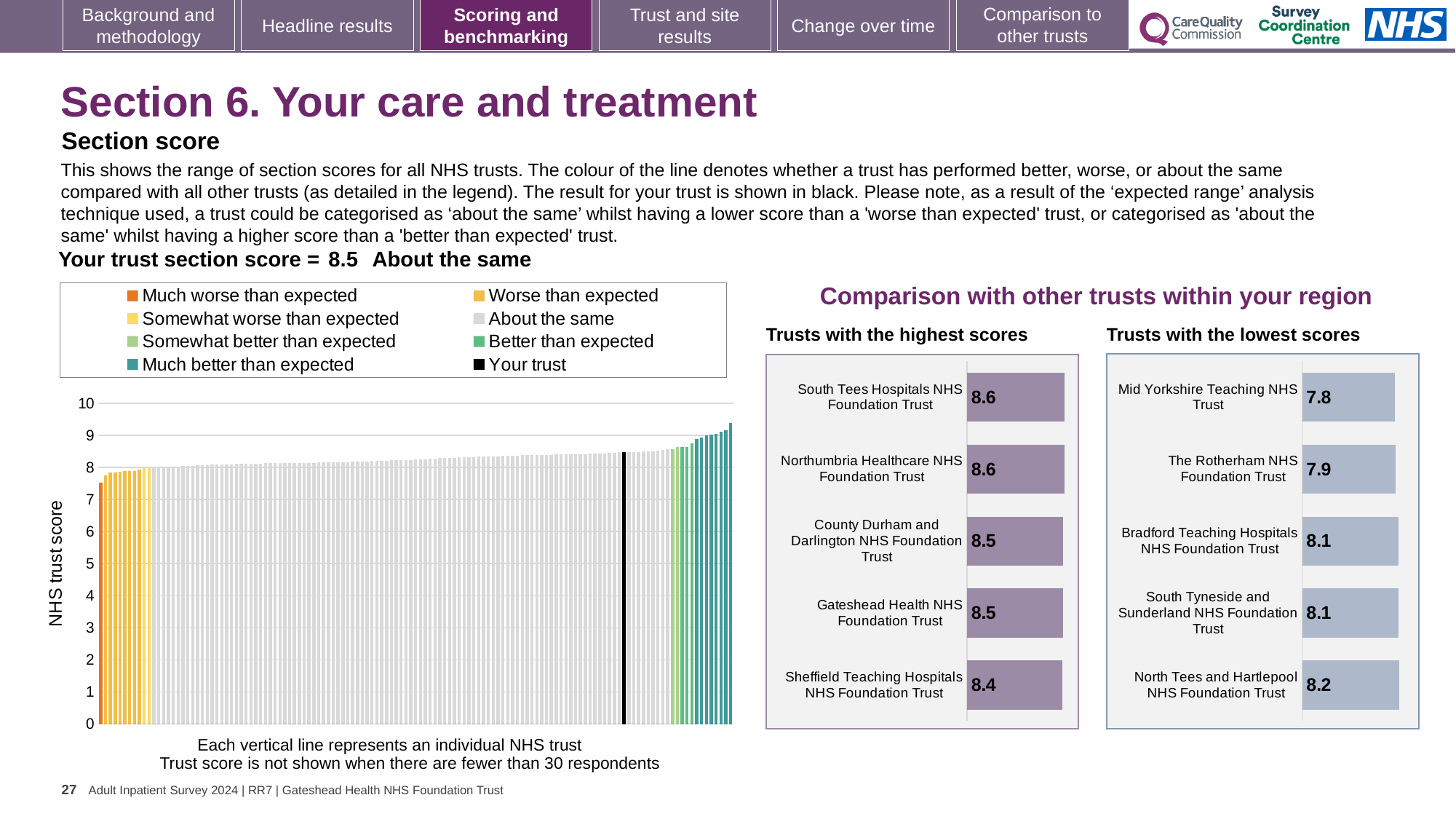
In the 'Trusts with the lowest scores' chart, which has the larger score: The Rotherham NHS Foundation Trust or Mid Yorkshire Teaching NHS Trust? The Rotherham NHS Foundation Trust In the 'Trusts with the highest scores' chart, what is the score for Sheffield Teaching Hospitals NHS Foundation Trust? 8.4 How many trusts are shown in the 'Trusts with the highest scores' chart? 5 How many entries does the legend of the NHS trust score chart list? 8 In the 'Trusts with the lowest scores' chart, which trust has the lowest score? Mid Yorkshire Teaching NHS Trust In the 'Trusts with the lowest scores' chart, what is the difference between the scores of North Tees and Hartlepool NHS Foundation Trust and Mid Yorkshire Teaching NHS Trust? 0.4 In the 'Trusts with the highest scores' chart, what is the difference between the scores of South Tees Hospitals NHS Foundation Trust and Sheffield Teaching Hospitals NHS Foundation Trust? 0.2 What kind of chart is the 'Trusts with the lowest scores' chart? Bar chart In the NHS trust score chart, do the values rise or fall from left to right along the x axis? Rise In the 'Trusts with the highest scores' chart, which trust has the lowest score? Sheffield Teaching Hospitals NHS Foundation Trust In the 'Trusts with the lowest scores' chart, what is the score for Bradford Teaching Hospitals NHS Foundation Trust? 8.1 In the NHS trust score chart, is the value of the black 'Your trust' bar greater or less than 8? greater